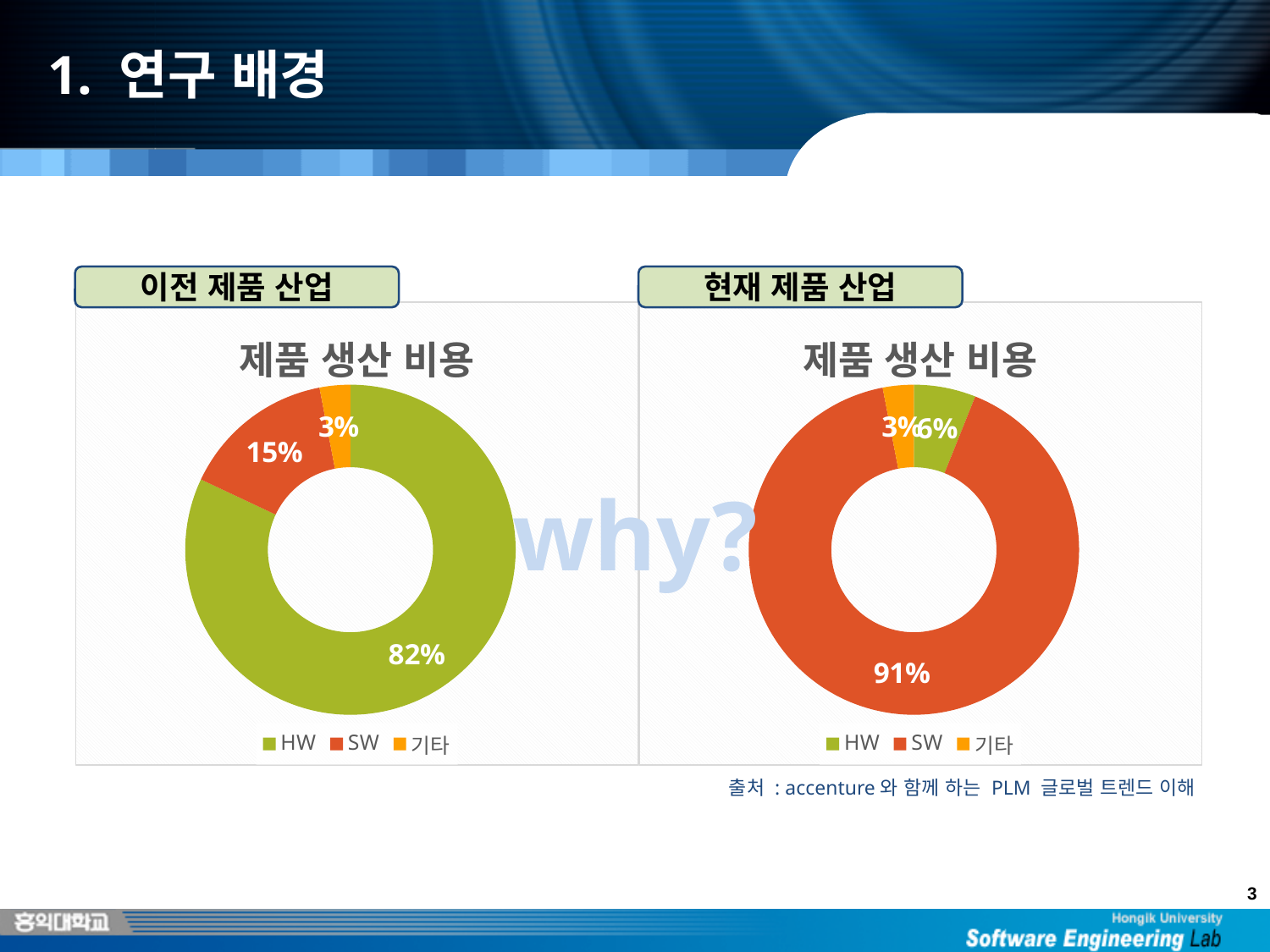
What is the title of the left chart (이전 제품 산업)? 제품 생산 비용 In the left chart (이전 제품 산업), which category has the largest share? HW How many categories does the legend of the left chart (이전 제품 산업) list? 3 In the left chart (이전 제품 산업), what is the value for HW? 82% In the right chart (현재 제품 산업), which category has the smallest share? 기타 In the right chart (현재 제품 산업), what is the value for SW? 91% In the left chart (이전 제품 산업), what is the value for SW? 15% In the left chart (이전 제품 산업), what is the difference between the HW and SW values? 67% In the right chart (현재 제품 산업), which is larger, HW or SW? SW In the right chart (현재 제품 산업), what is the value for 기타? 3% What kind of chart is the right chart (현재 제품 산업)? Doughnut chart In the right chart (현재 제품 산업), what is the value for HW? 6%